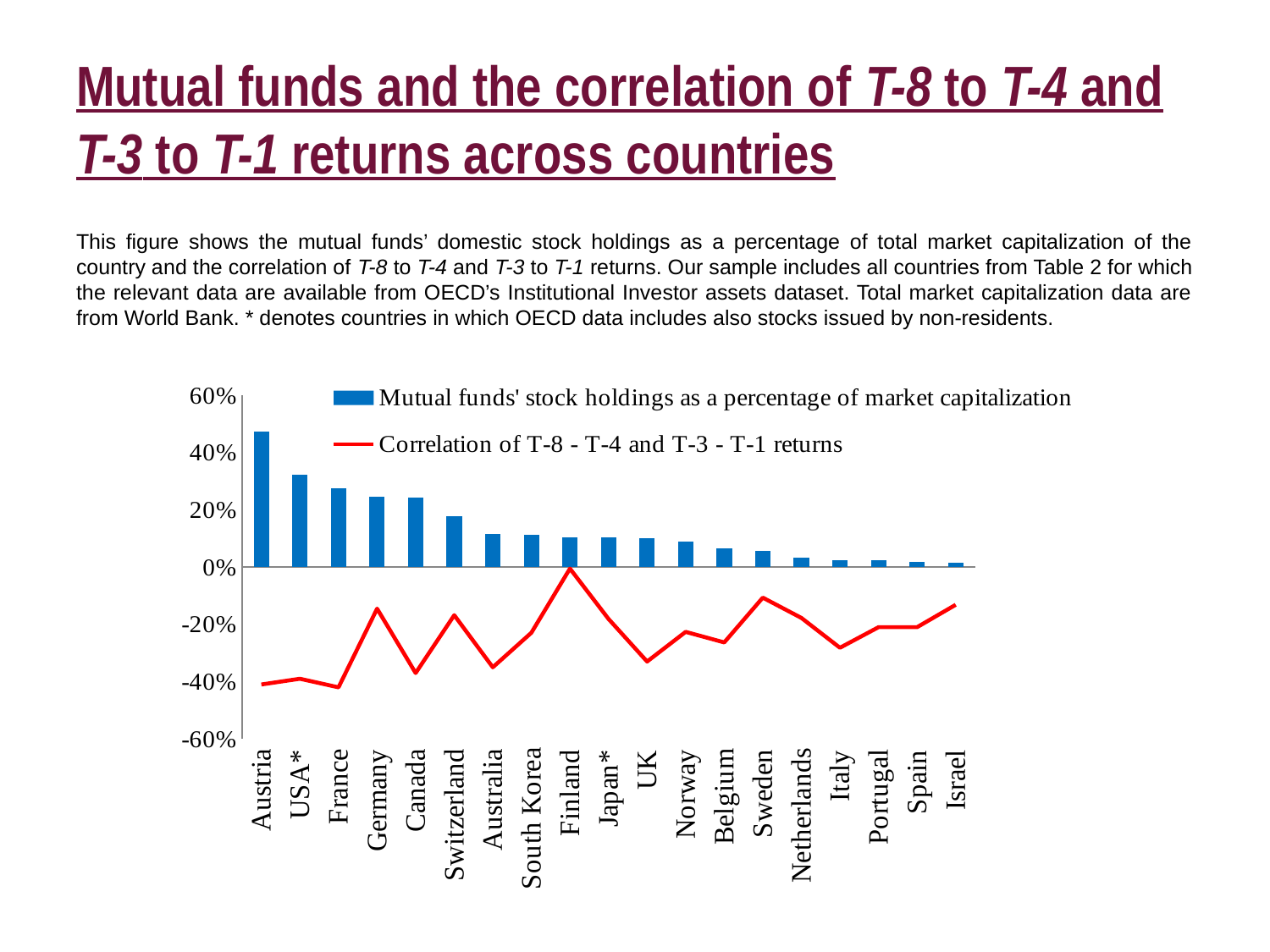
Which has the larger mutual funds' stock holdings bar, Switzerland or Australia? Switzerland Is the mutual funds' stock holdings value for USA* greater or less than 40%? less Which country has the highest correlation of T-8 - T-4 and T-3 - T-1 returns? Finland Which country has the lowest mutual funds' stock holdings as a percentage of market capitalization? Israel Which country has the highest mutual funds' stock holdings as a percentage of market capitalization? Austria Do the mutual funds' stock holdings bars rise or fall from left to right along the x axis? Fall How many series does the legend list? 2 How many countries are shown on the x axis? 19 What colour is the line for the correlation of T-8 - T-4 and T-3 - T-1 returns? Red Is the correlation of T-8 - T-4 and T-3 - T-1 returns for Austria greater or less than -20%? less What kind of chart is shown on the slide? A bar chart combined with a line chart Is the mutual funds' stock holdings value for Austria greater or less than 40%? greater